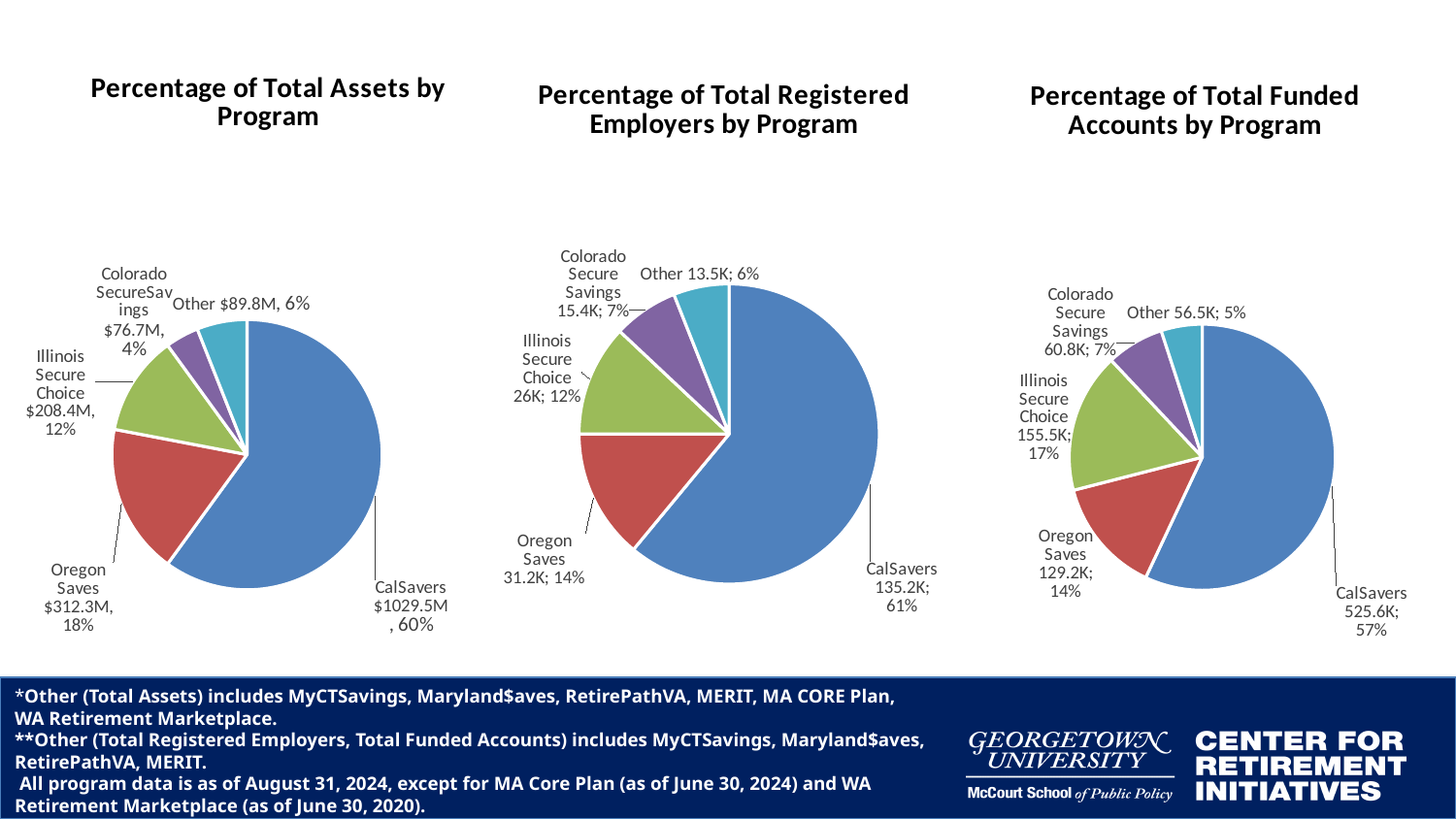
How many slices does the 'Percentage of Total Funded Accounts by Program' chart have? 5 In the 'Percentage of Total Assets by Program' chart, what share of the pie does Oregon Saves have? 18% What type of chart is used for 'Percentage of Total Assets by Program'? Pie chart How many charts are shown on the slide? 3 In the 'Percentage of Total Registered Employers by Program' chart, which program has the largest slice? CalSavers In the 'Percentage of Total Funded Accounts by Program' chart, what value is shown for Colorado Secure Savings? 60.8K; 7% In the 'Percentage of Total Registered Employers by Program' chart, what is the difference in percentage points between Oregon Saves and Other? 8 percentage points In the 'Percentage of Total Assets by Program' chart, which program has the smallest slice? Colorado SecureSavings In the 'Percentage of Total Assets by Program' chart, what value is shown for CalSavers? $1029.5M, 60% In the 'Percentage of Total Funded Accounts by Program' chart, which is larger, Illinois Secure Choice or Oregon Saves? Illinois Secure Choice In the 'Percentage of Total Registered Employers by Program' chart, what value is shown for Illinois Secure Choice? 26K; 12% In the 'Percentage of Total Funded Accounts by Program' chart, what share of the pie does CalSavers have? 57%